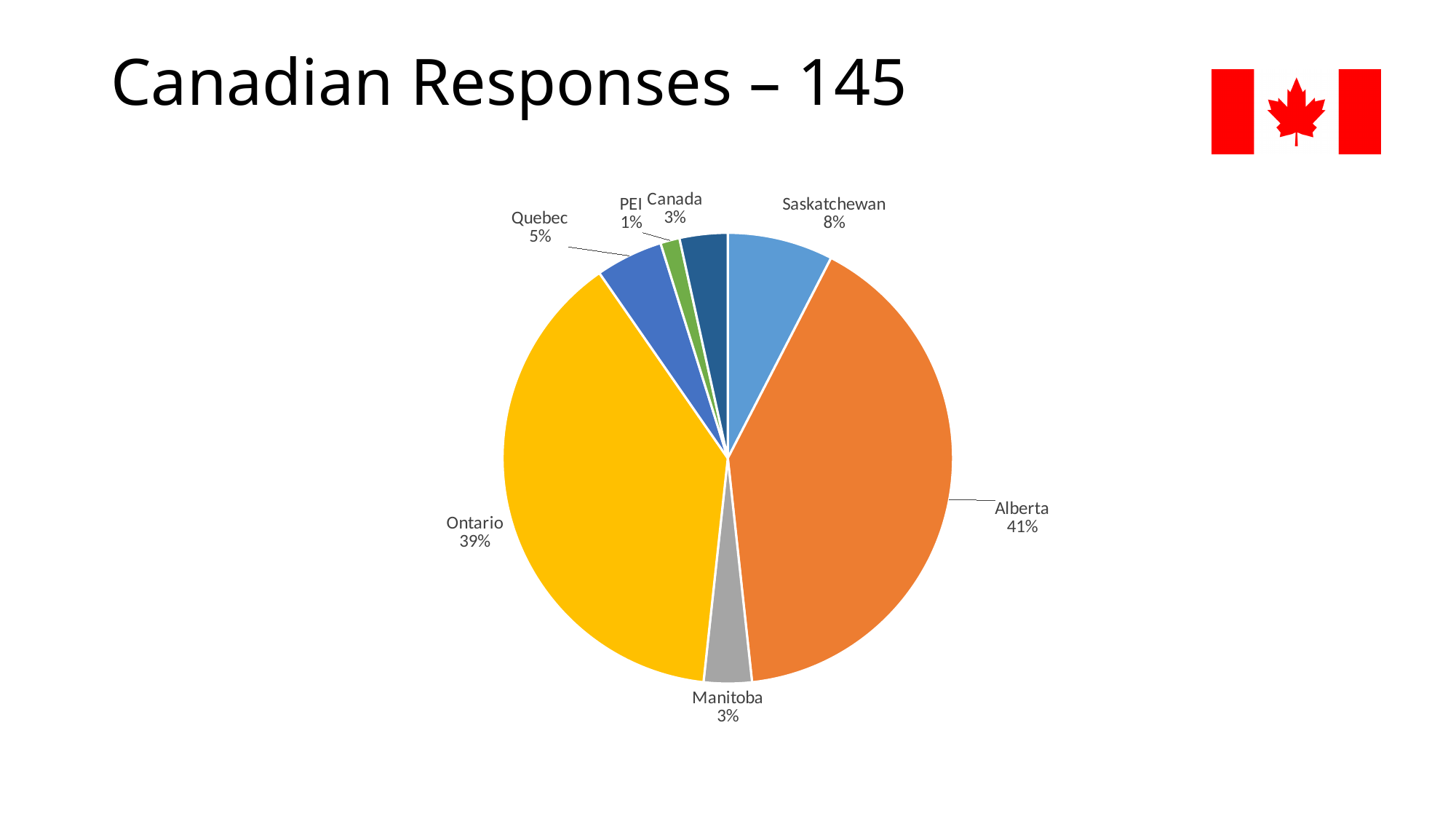
What is the difference in percentage points between Alberta and Ontario? 2 What percentage is shown for Quebec? 5% What percentage is shown for PEI? 1% Which is larger, the share for Saskatchewan or the share for Quebec? Saskatchewan What kind of chart is shown on the slide? pie chart Which region has the smallest slice of the pie? PEI What percentage is shown for Saskatchewan? 8% What share of Canadian responses came from Alberta? 41% What is the title of the slide containing the pie chart? Canadian Responses – 145 How many slices does the pie chart have? 7 What share of Canadian responses came from Ontario? 39% Which region has the largest slice of the pie? Alberta